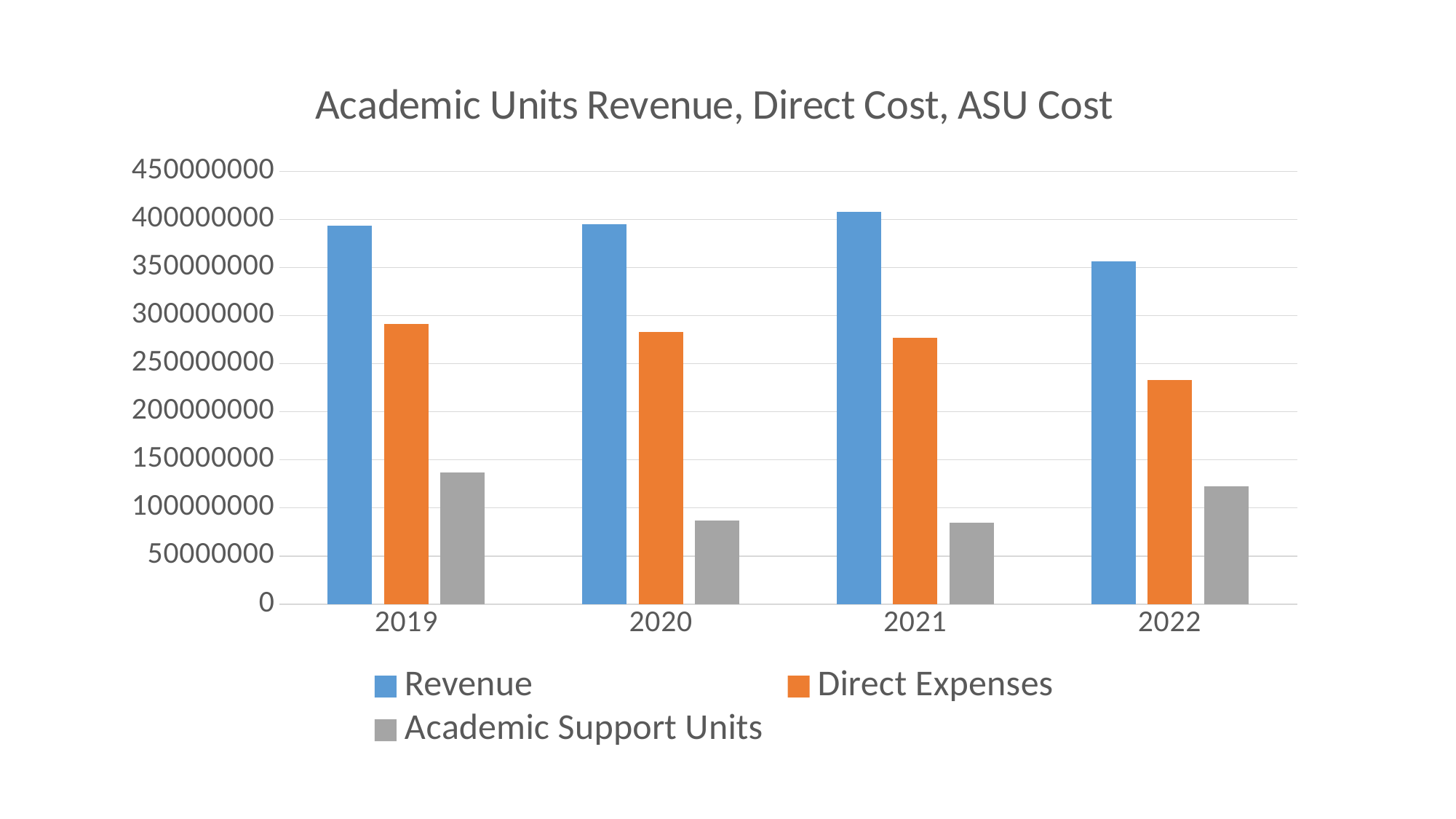
Is the Direct Expenses value for 2022 greater or less than 250000000? less How many years are shown on the x axis? 4 Is the Revenue value for 2021 greater or less than 400000000? greater Which year has the highest Revenue? 2021 What type of chart is shown on the slide? bar chart Which year has the lowest Revenue? 2022 What is the title of the chart? Academic Units Revenue, Direct Cost, ASU Cost Do the Direct Expenses values rise or fall from 2019 to 2022? fall How many series does the legend list? 3 Is the Academic Support Units value for 2020 greater or less than 100000000? less Which year has the highest Academic Support Units value? 2019 Which year has the lowest Direct Expenses? 2022